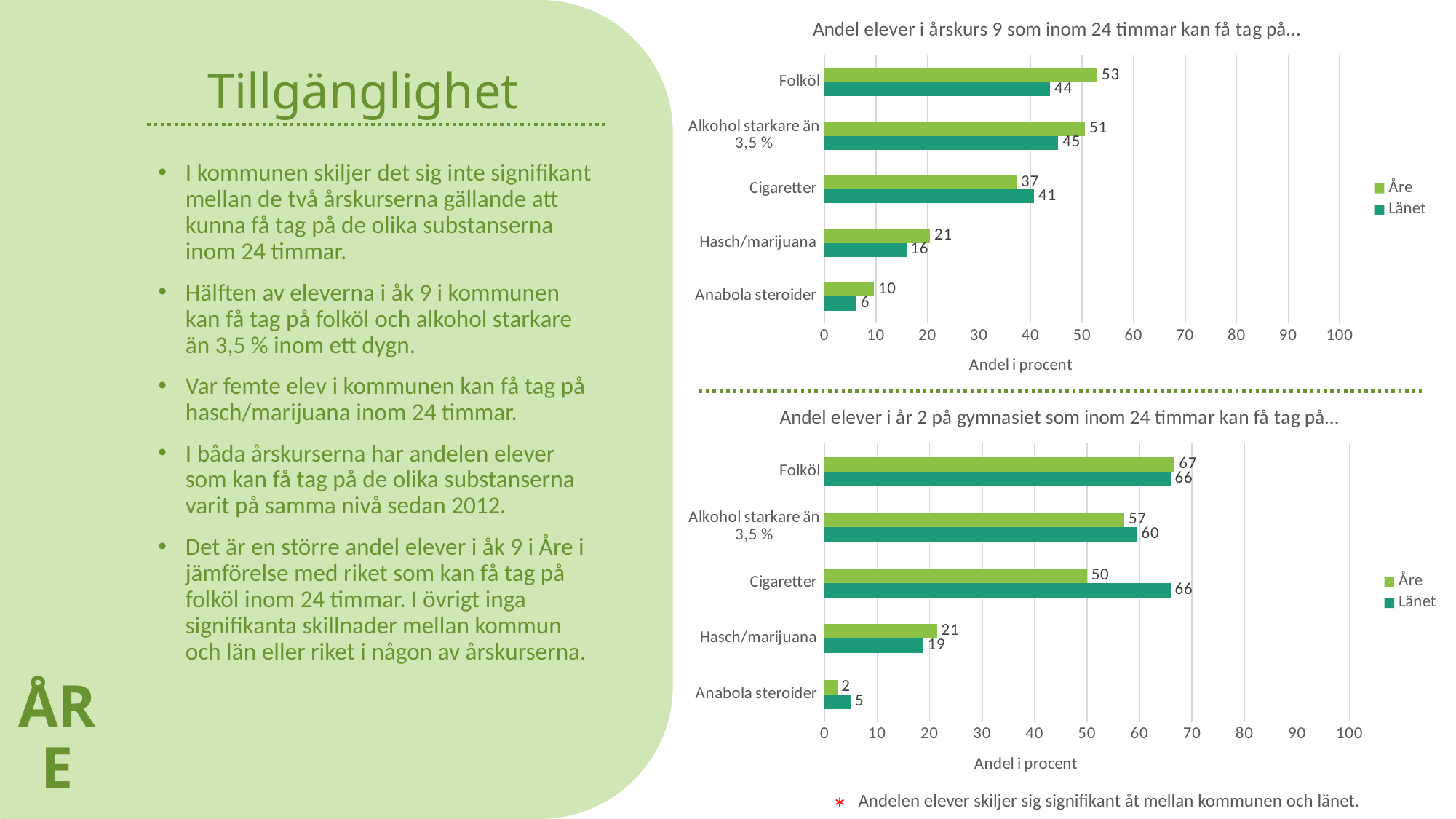
In the top chart (årskurs 9), which is larger for Hasch/marijuana, Åre or Länet? Åre In the top chart (Andel elever i årskurs 9 som inom 24 timmar kan få tag på…), what is the value for Åre for Folköl? 53 In the bottom chart (år 2 på gymnasiet), which category has the highest value for Åre? Folköl In the top chart (årskurs 9), which category has the lowest value for Åre? Anabola steroider In the bottom chart (år 2 på gymnasiet), what is the value for Åre for Anabola steroider? 2 In the bottom chart (år 2 på gymnasiet), what is the difference between Länet and Åre for Cigaretter? 16 In the bottom chart (Andel elever i år 2 på gymnasiet som inom 24 timmar kan få tag på…), what is the value for Länet for Cigaretter? 66 How many categories are shown in the bottom chart (år 2 på gymnasiet)? 5 How many series does the legend of the top chart (årskurs 9) list? 2 In the top chart (årskurs 9), what is the difference between Åre and Länet for Folköl? 9 In the top chart (årskurs 9), what is the value for Länet for Cigaretter? 41 What kind of chart is the top chart (årskurs 9)? Bar chart